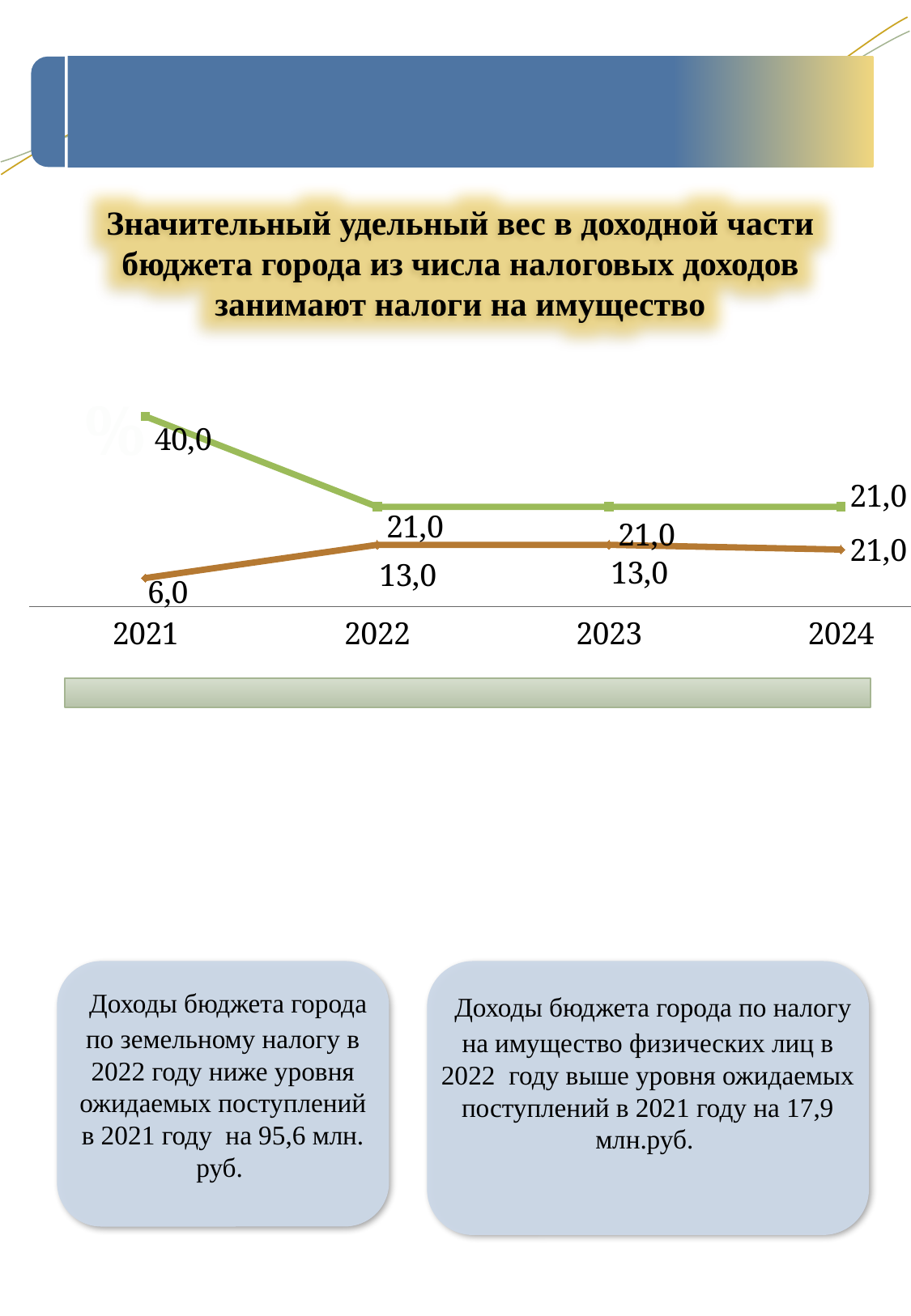
What is the value of the brown line in 2021? 6,0 What kind of chart is shown on the slide? line chart What is the value of the green line in 2024? 21,0 What is the value of the green line in 2021? 40,0 In which year does the green line reach its highest value? 2021 By how much does the green line fall from 2021 to 2022? 19,0 In which year does the brown line have its lowest value? 2021 What is the value of the brown line in 2022? 13,0 Does the brown line rise or fall from 2021 to 2024? rise Which line has the larger value in 2021, the green line or the brown line? green line How many years are shown on the x axis of the chart? 4 What is the difference between the green line and the brown line in 2021? 34,0